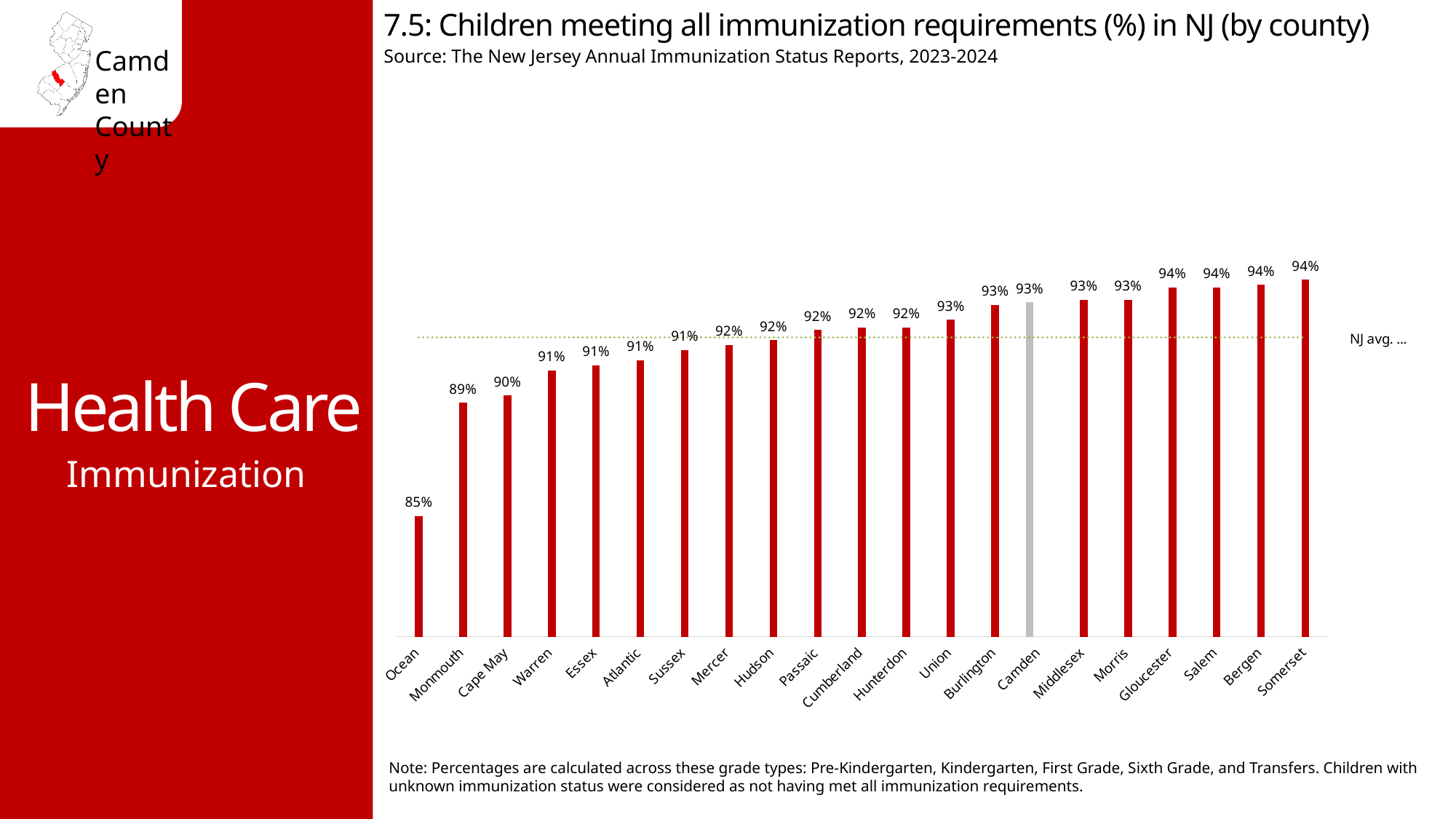
What is the value for Cape May? 90% Which county's bar is coloured grey instead of red? Camden What percentage is shown for Monmouth County? 89% What is the value shown for Ocean County? 85% What is the difference in percentage points between Camden (93%) and Ocean (85%)? 8 percentage points Which county has a higher value, Ocean or Somerset? Somerset Which county has the lowest percentage of children meeting all immunization requirements? Ocean How many counties are shown on the chart? 21 What percentage is shown for Somerset County? 94% What kind of chart is shown on the slide? Bar chart Do the values generally rise or fall moving from left to right across the counties? Rise What percentage of children in Camden County met all immunization requirements? 93%